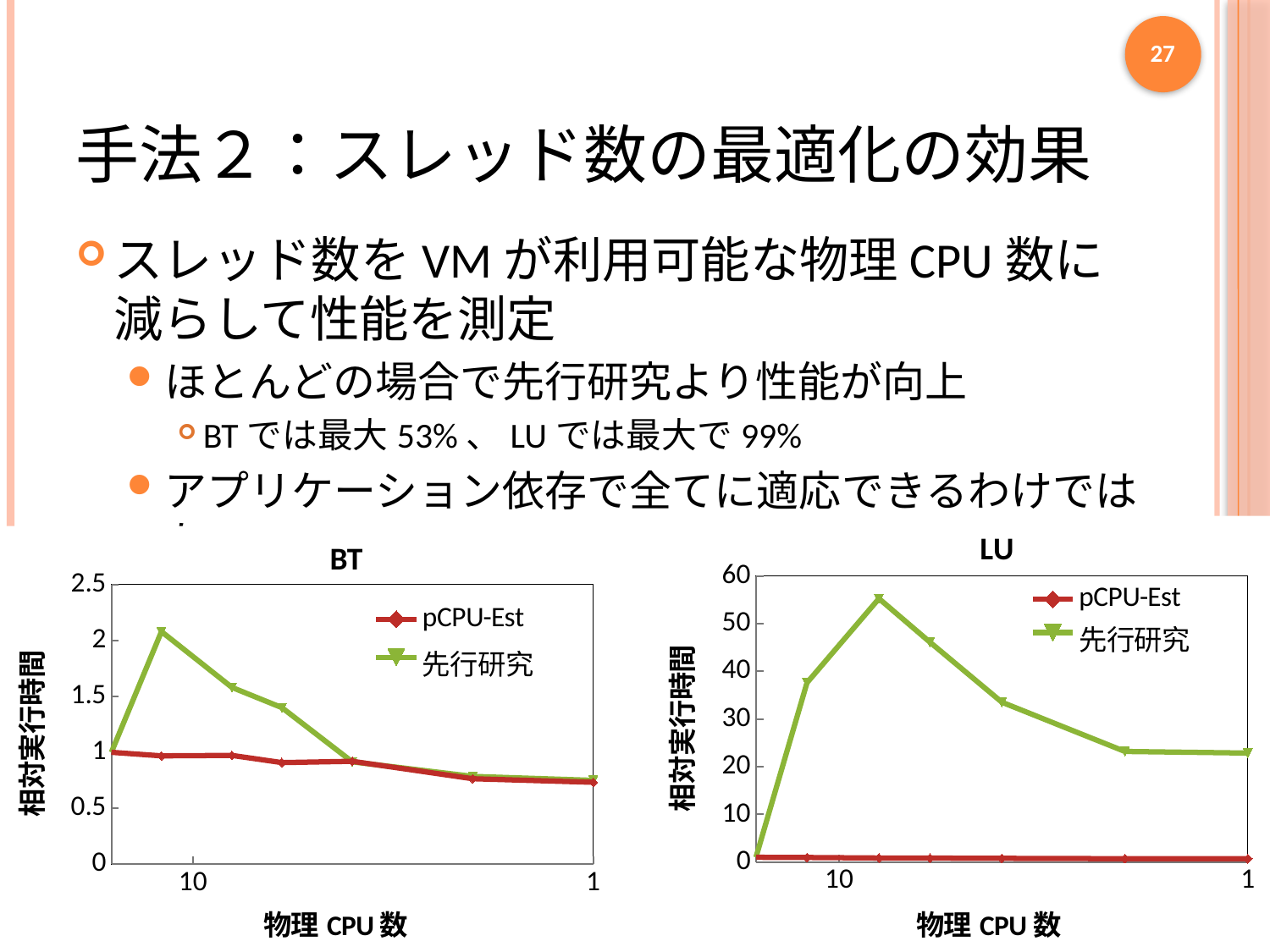
In the LU chart, is the peak value of the 先行研究 line greater or less than 50? greater What is the x-axis label of the BT chart? 物理 CPU 数 How many charts are shown on the slide? 2 What kind of chart is the BT chart? line chart In the BT chart, which series reaches the higher peak value, pCPU-Est or 先行研究? 先行研究 In the LU chart, is the value of the pCPU-Est line greater or less than 10? less In the BT chart, is the peak value of the 先行研究 line greater or less than 1.5? greater In the LU chart, which series has the lower values across the whole x axis? pCPU-Est How many series does the legend of the LU chart list? 2 What is the title of the chart on the right side of the slide? LU In the LU chart, do the 先行研究 values rise or fall from the peak toward the right end of the x axis? fall